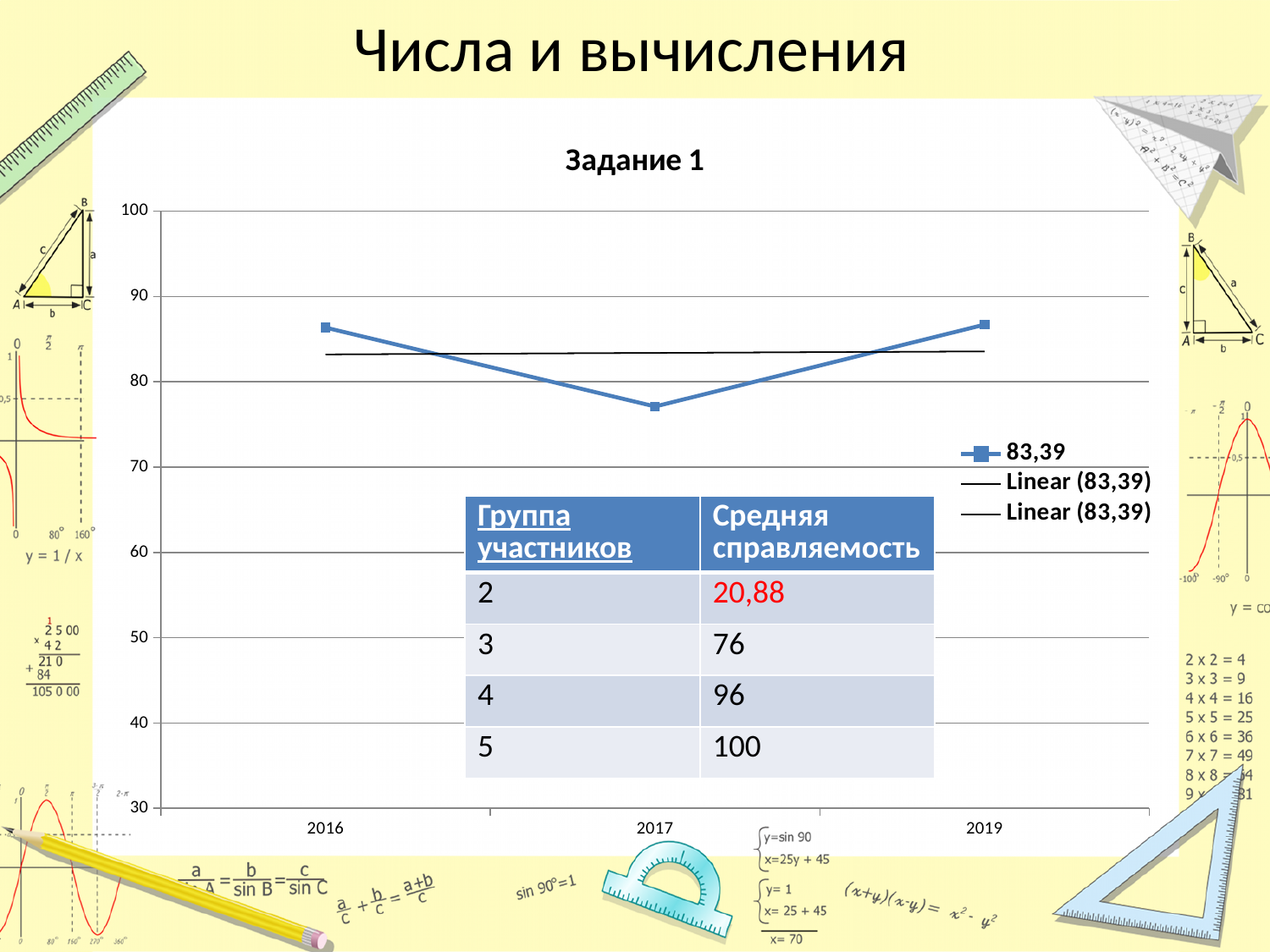
Is the value for 2017 greater or less than 80? less What kind of chart is shown on the slide? line chart Is the value for 2016 greater or less than 80? greater What is the highest value shown on the y axis? 100 What is the title of the chart? Задание 1 Which year has the lowest value on the plotted line? 2017 Does the plotted line rise or fall from 2017 to 2019? rise Is the value for 2019 greater or less than 90? less What is the name of the first series listed in the legend? 83,39 How many data points are plotted on the line in the chart? 3 How many series does the chart legend list? 3 Which is larger, the value for 2016 or the value for 2017? 2016